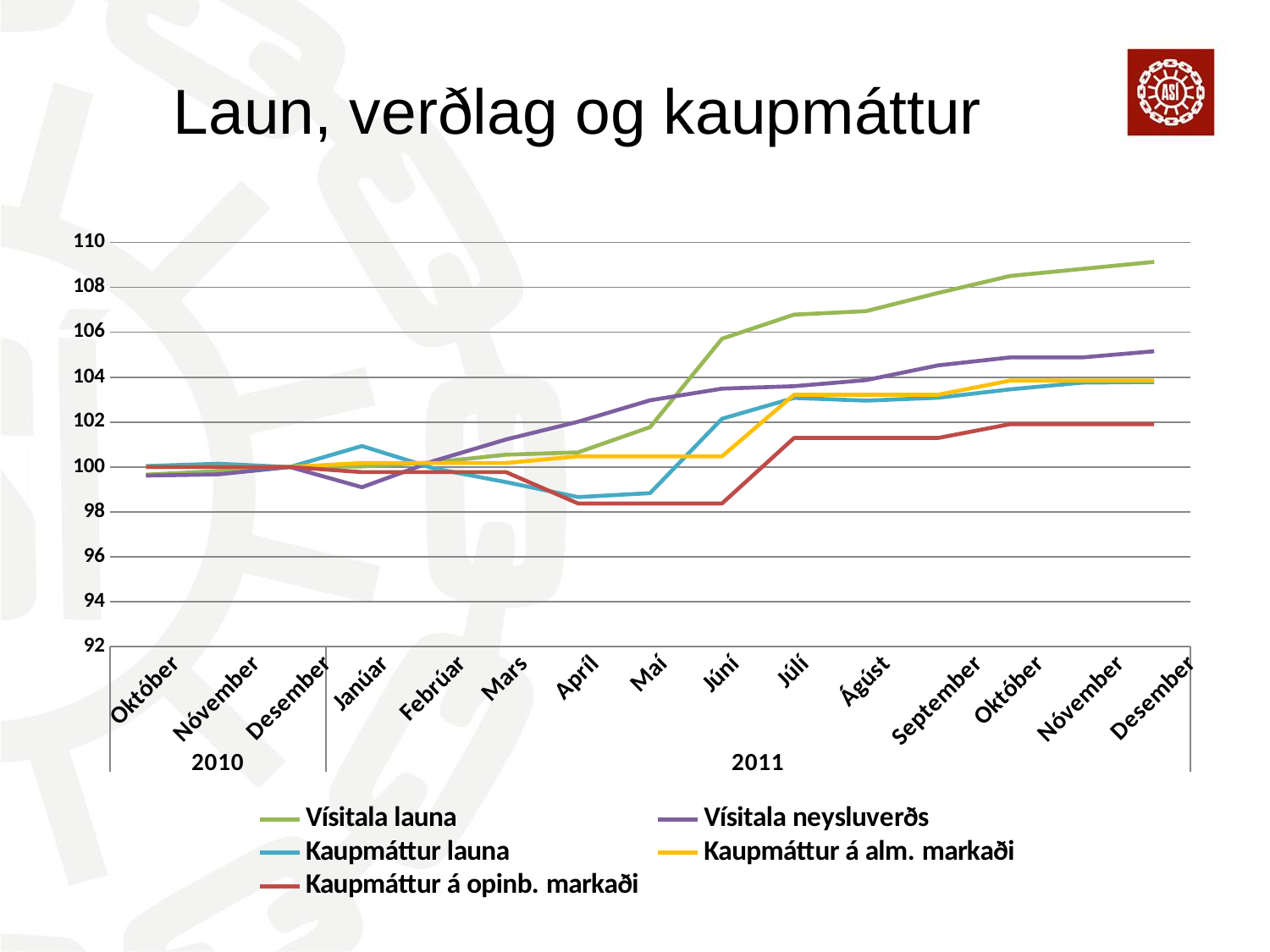
Is the value for Vísitala neysluverðs in Desember 2011 greater or less than 104? greater Which series is highest in Desember 2011? Vísitala launa What is the title of the slide? Laun, verðlag og kaupmáttur Which series is lowest in Desember 2011? Kaupmáttur á opinb. markaði How many series does the legend list? 5 Does the Vísitala launa series rise or fall from Október 2010 to Desember 2011? rise How many months are plotted along the x axis? 15 What colour is the line for Vísitala launa? green In Desember 2011, which is larger: Vísitala launa or Vísitala neysluverðs? Vísitala launa Is the value for Kaupmáttur á opinb. markaði in Júní 2011 greater or less than 100? less What kind of chart is shown on the slide? line chart Is the value for Vísitala launa in Desember 2011 greater or less than 108? greater